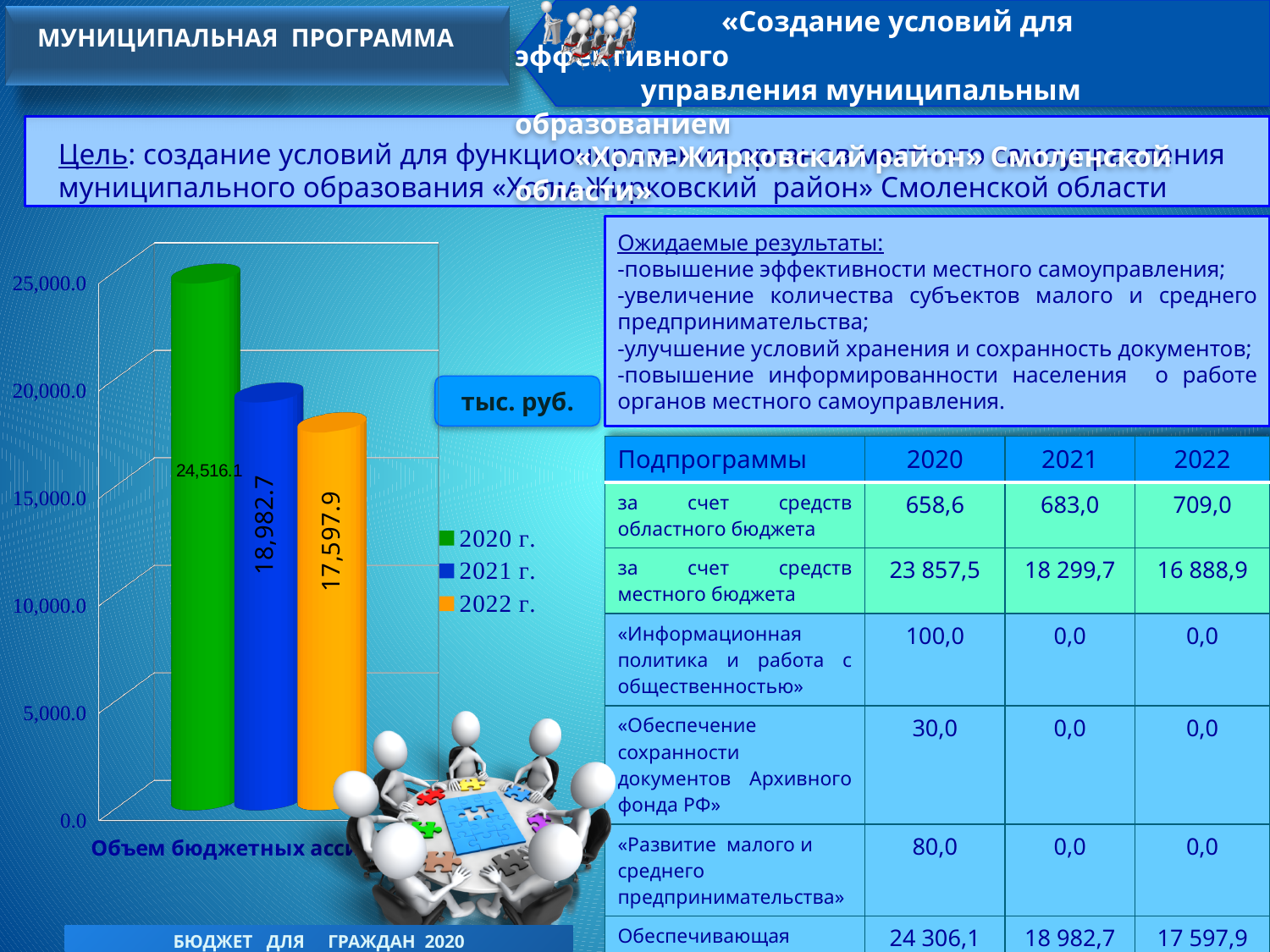
Which is larger in the chart, the value for 2021 г. or the value for 2022 г.? 2021 г. What is the difference between the values for 2020 г. and 2021 г. in the chart? 5,533.4 How many bars are plotted in the chart? 3 What is the difference between the values for 2021 г. and 2022 г. in the chart? 1,384.8 What is the value of the bar for 2020 г. in the chart? 24,516.1 What is the value of the bar for 2021 г. in the chart? 18,982.7 How many entries does the chart legend list? 3 Which year has the lowest bar in the chart? 2022 г. Which year has the highest bar in the chart? 2020 г. Is the value for 2020 г. in the chart greater or less than 20,000.0? greater What type of chart is shown on the slide? Bar chart What is the value of the bar for 2022 г. in the chart? 17,597.9